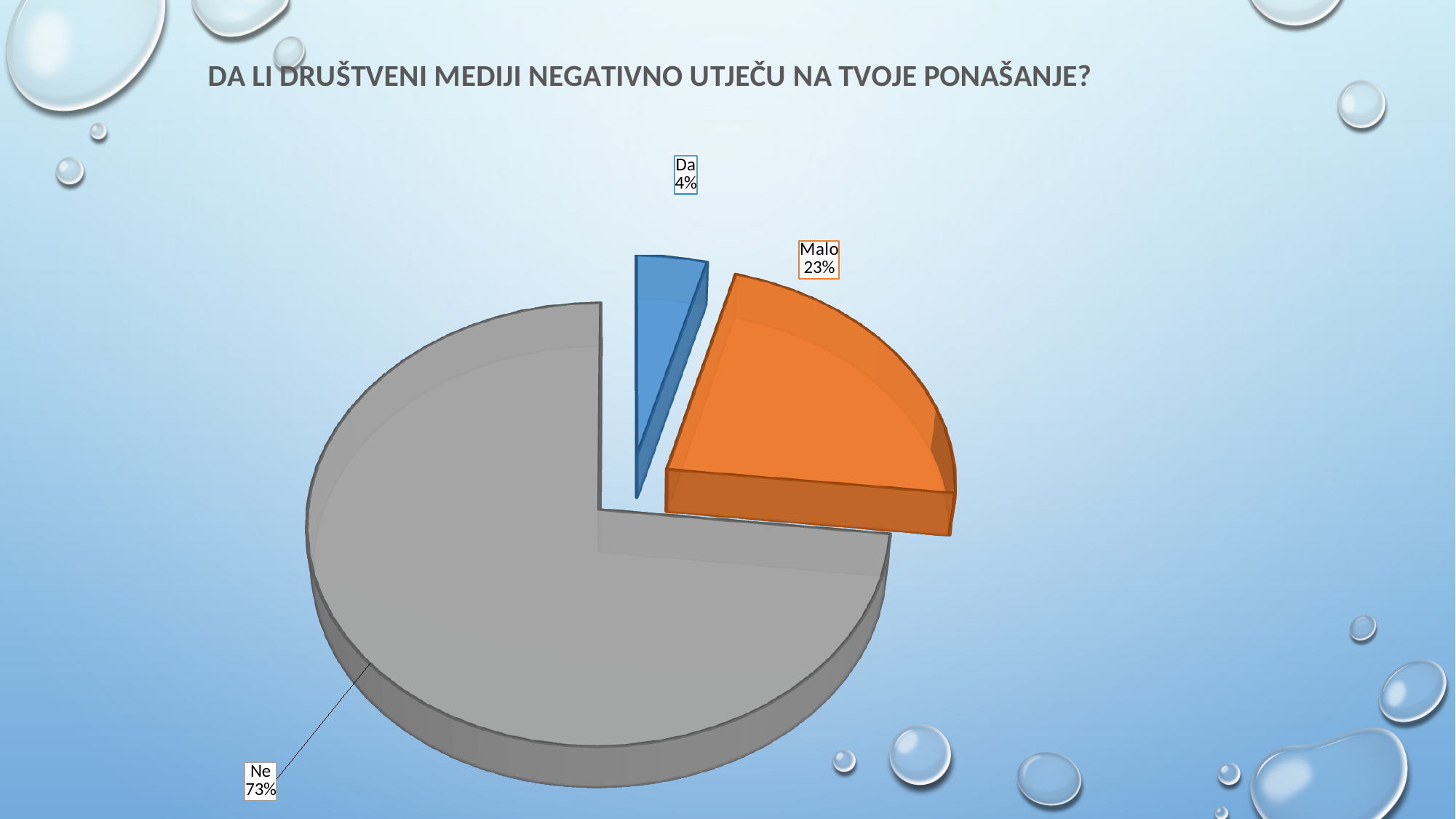
What is the difference in percentage points between "Ne" and "Malo"? 50 How many slices does the pie chart have? 3 Which answer has the largest share of the pie? Ne What percentage of respondents answered "Ne"? 73% What percentage of respondents answered "Malo"? 23% What is the difference in percentage points between "Malo" and "Da"? 19 Which answer has the smallest share of the pie? Da Which is larger, the share for "Malo" or the share for "Da"? Malo What colour is the "Malo" slice? Orange What percentage of respondents answered "Da"? 4% What is the title of the chart on the slide? Da li društveni mediji negativno utječu na tvoje ponašanje? What kind of chart is shown on the slide? Pie chart